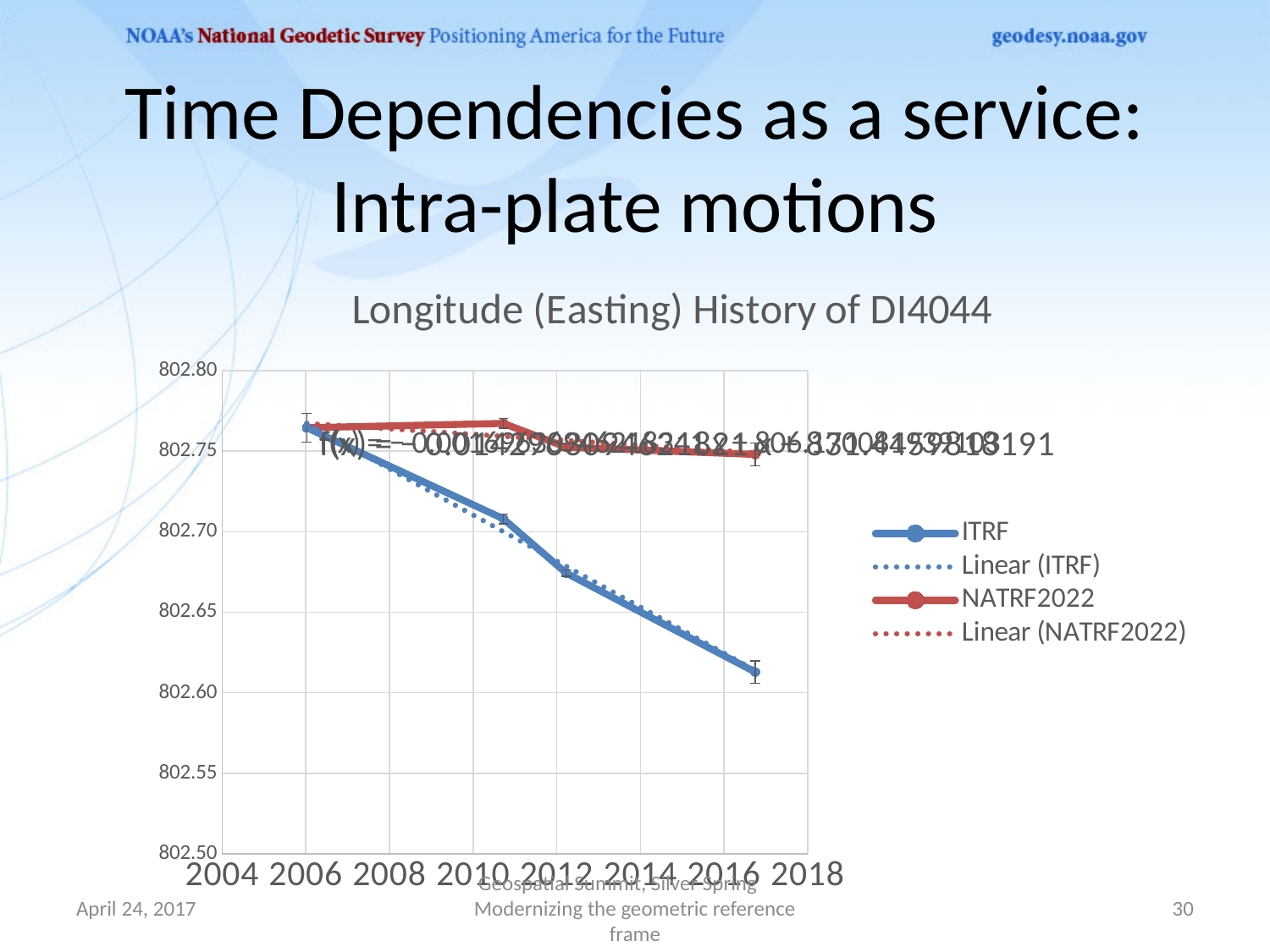
Does the ITRF series rise or fall as the years increase along the x axis? fall In which year does the ITRF series reach its lowest value? 2016 What is the title of the chart? Longitude (Easting) History of DI4044 In which year does the ITRF series reach its highest value? 2006 Which colour is used for the NATRF2022 series in the chart? red At 2016, which series has the larger value, ITRF or NATRF2022? NATRF2022 Is the NATRF2022 value at 2006 greater or less than 802.75? greater What type of chart is shown on the slide? line chart Is the ITRF value at 2016 greater or less than 802.65? less How many entries does the chart legend list? 4 How many data points are plotted for the ITRF series? 4 Is the ITRF value at 2012 greater or less than 802.70? less